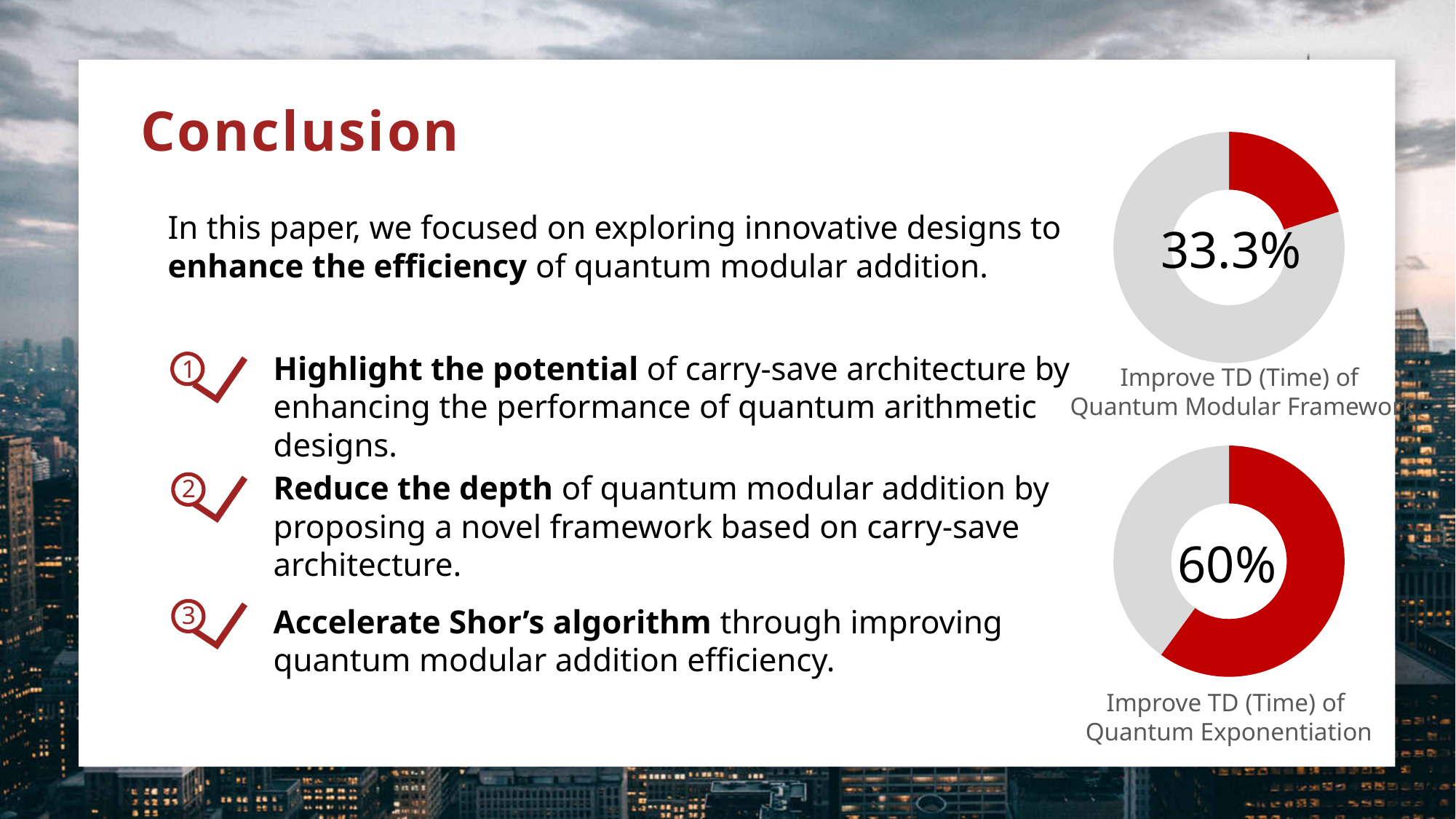
What value is shown in the centre of the bottom donut chart, labelled 'Improve TD (Time) of Quantum Exponentiation'? 60% What kind of chart is used on the right side of the slide to show the improvement percentages? Donut (pie) chart What value is shown in the centre of the top donut chart, labelled 'Improve TD (Time) of Quantum Modular Framework'? 33.3% Which chart shows the larger improvement: the top chart (Quantum Modular Framework) or the bottom chart (Quantum Exponentiation)? The bottom chart (Quantum Exponentiation) In the bottom donut chart (Quantum Exponentiation), what share of the ring is filled in red? 60% What is the difference between the percentage in the bottom chart (Quantum Exponentiation) and the percentage in the top chart (Quantum Modular Framework)? 26.7% What is the caption below the top donut chart? Improve TD (Time) of Quantum Modular Framework How many donut charts are shown on the slide? 2 In the top donut chart, is the red (filled) portion greater or less than 50%? less What colour is used for the filled (highlighted) portion of both donut charts? Red In the bottom donut chart, is the red (filled) portion greater or less than 50%? greater